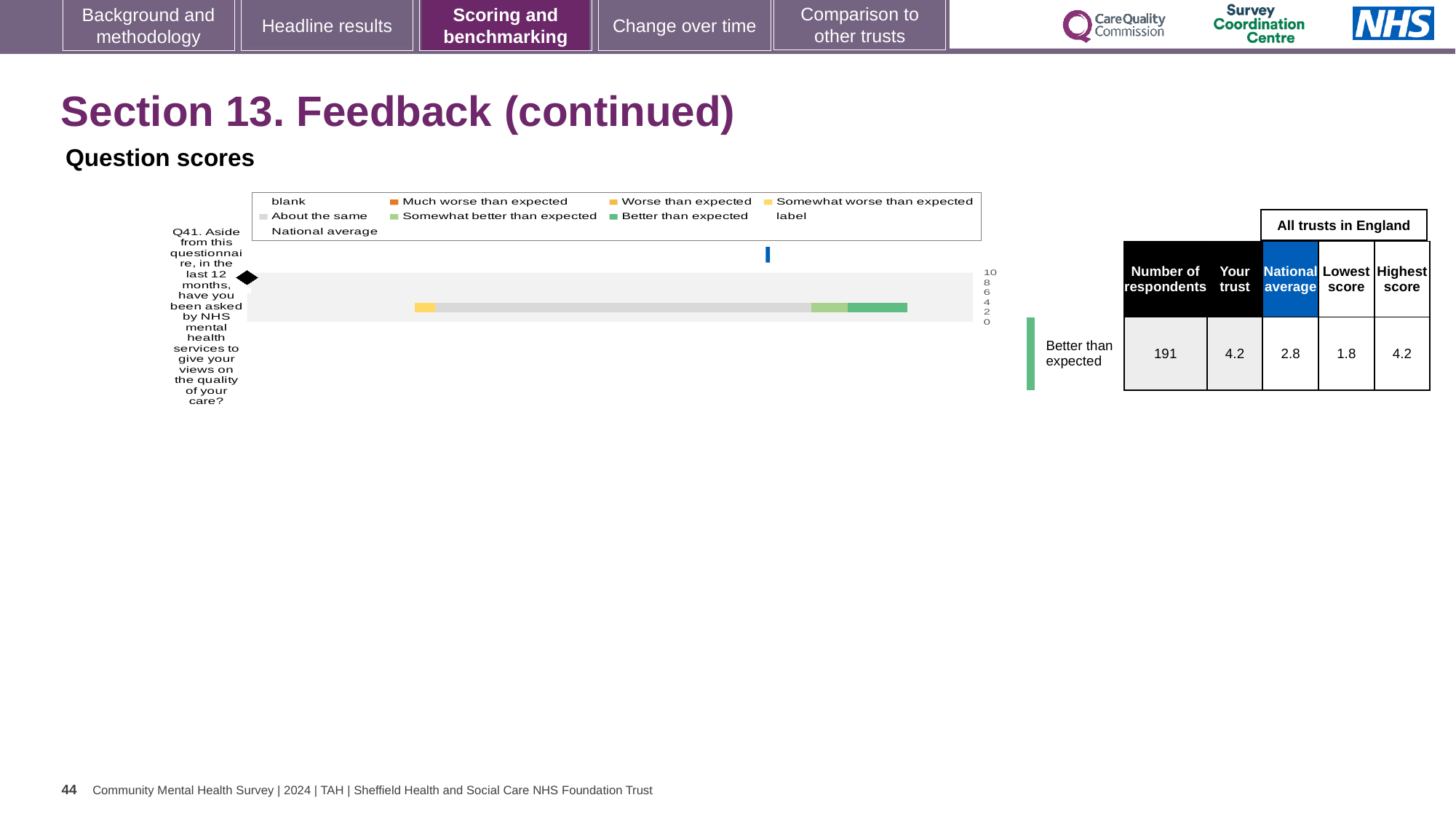
What is the lowest score among all trusts in England for Q41? 1.8 Which is larger for Q41, the 'Your trust' score or the national average? Your trust Which question number is plotted in the chart? Q41 What is the highest score among all trusts in England for Q41? 4.2 What is the 'Your trust' score for Q41? 4.2 How many entries does the chart legend list? 9 What is the difference between the 'Your trust' score and the national average for Q41? 1.4 What kind of chart is shown under 'Question scores'? bar chart What benchmark category is shown next to the chart for Q41? Better than expected What is the number of respondents for Q41? 191 What is the national average score for Q41? 2.8 How many questions are plotted in the chart? 1